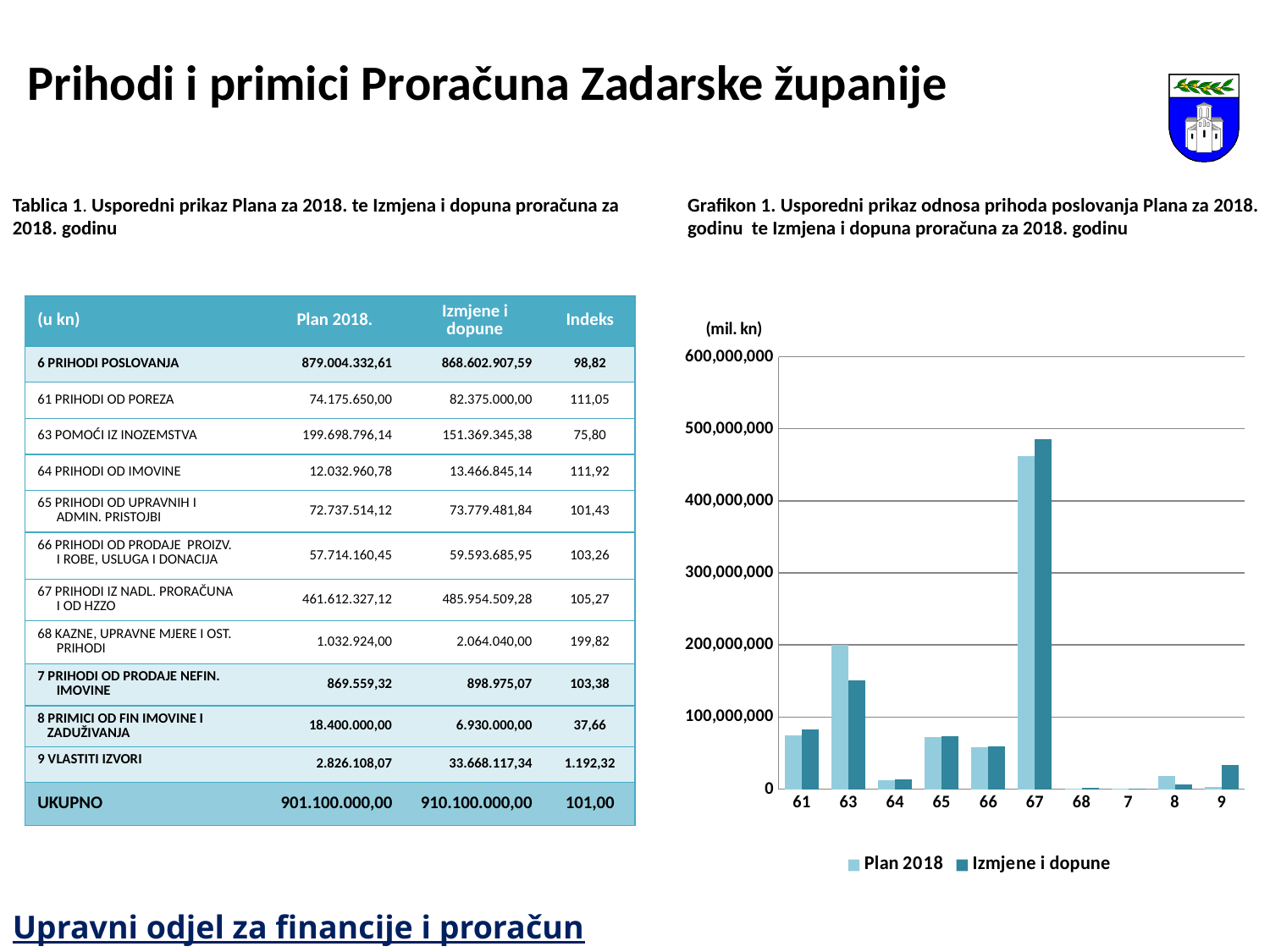
How many categories are shown on the x axis of the chart? 10 What kind of chart is Grafikon 1 on the slide? bar chart Which category has the highest Plan 2018 value in the chart? 67 For category 63, which series has the larger value, Plan 2018 or Izmjene i dopune? Plan 2018 Is the Izmjene i dopune value for category 63 greater or less than 200,000,000? less Is the Plan 2018 value for category 67 greater or less than 400,000,000? greater For category 9, which series has the larger value, Plan 2018 or Izmjene i dopune? Izmjene i dopune For category 8, which series has the larger value, Plan 2018 or Izmjene i dopune? Plan 2018 Which category has the highest Izmjene i dopune value in the chart? 67 Is the Plan 2018 value for category 61 greater or less than 100,000,000? less What unit label is shown above the vertical axis of the chart? (mil. kn) How many series does the legend of the chart list? 2